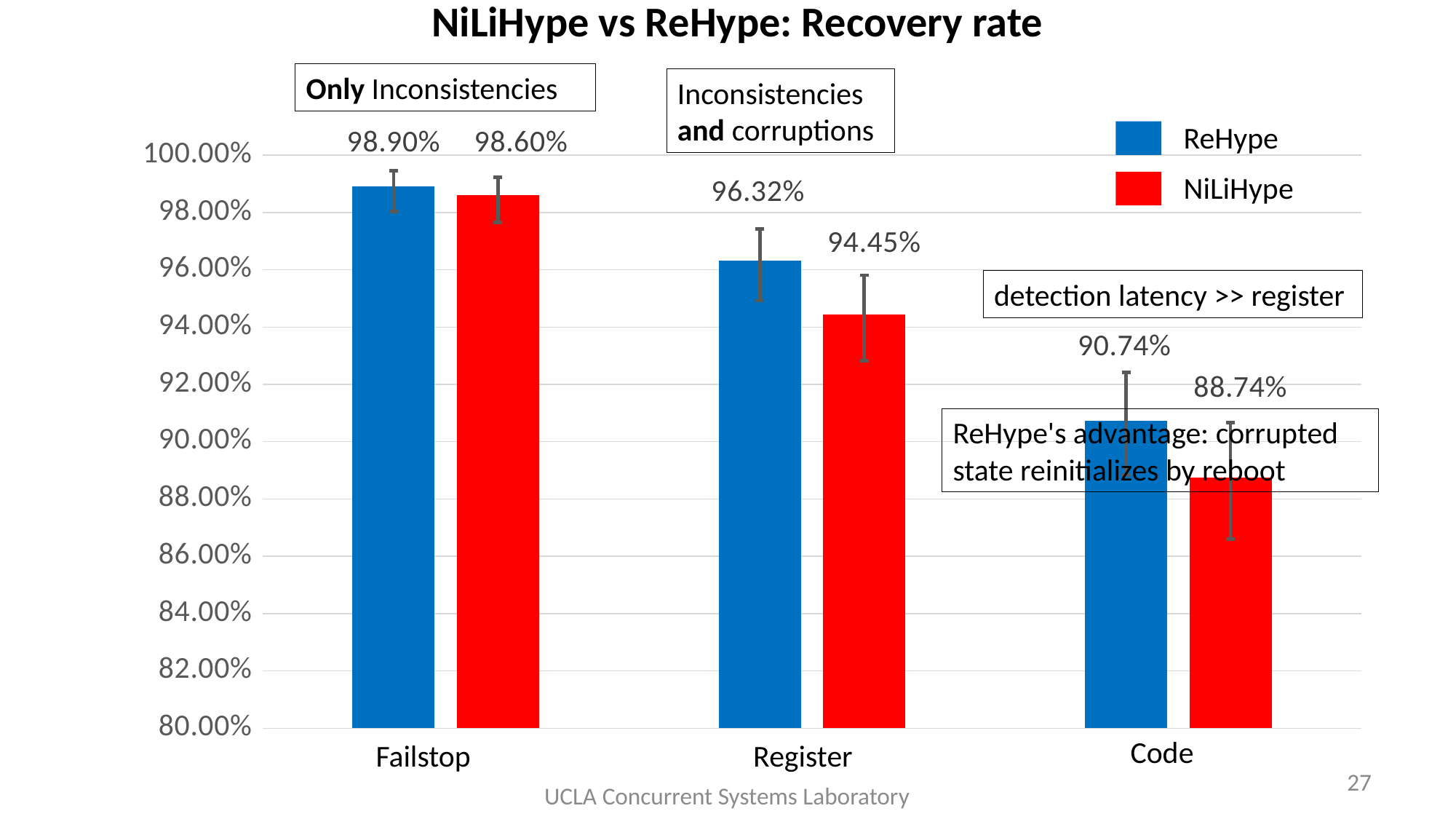
What is the recovery rate for NiLiHype in the Code category? 88.74% What is the difference between the ReHype and NiLiHype recovery rates in the Code category? 2.00% What is the difference between the ReHype and NiLiHype recovery rates in the Register category? 1.87% In the Register category, which series has the higher recovery rate, ReHype or NiLiHype? ReHype What is the recovery rate for ReHype in the Failstop category? 98.90% Which category has the lowest recovery rate for NiLiHype? Code Which category has the highest recovery rate for ReHype? Failstop What type of chart is shown on the slide? Bar chart How many series does the legend list? 2 How many categories are shown on the x axis? 3 What is the recovery rate for ReHype in the Code category? 90.74% What is the recovery rate for NiLiHype in the Register category? 94.45%